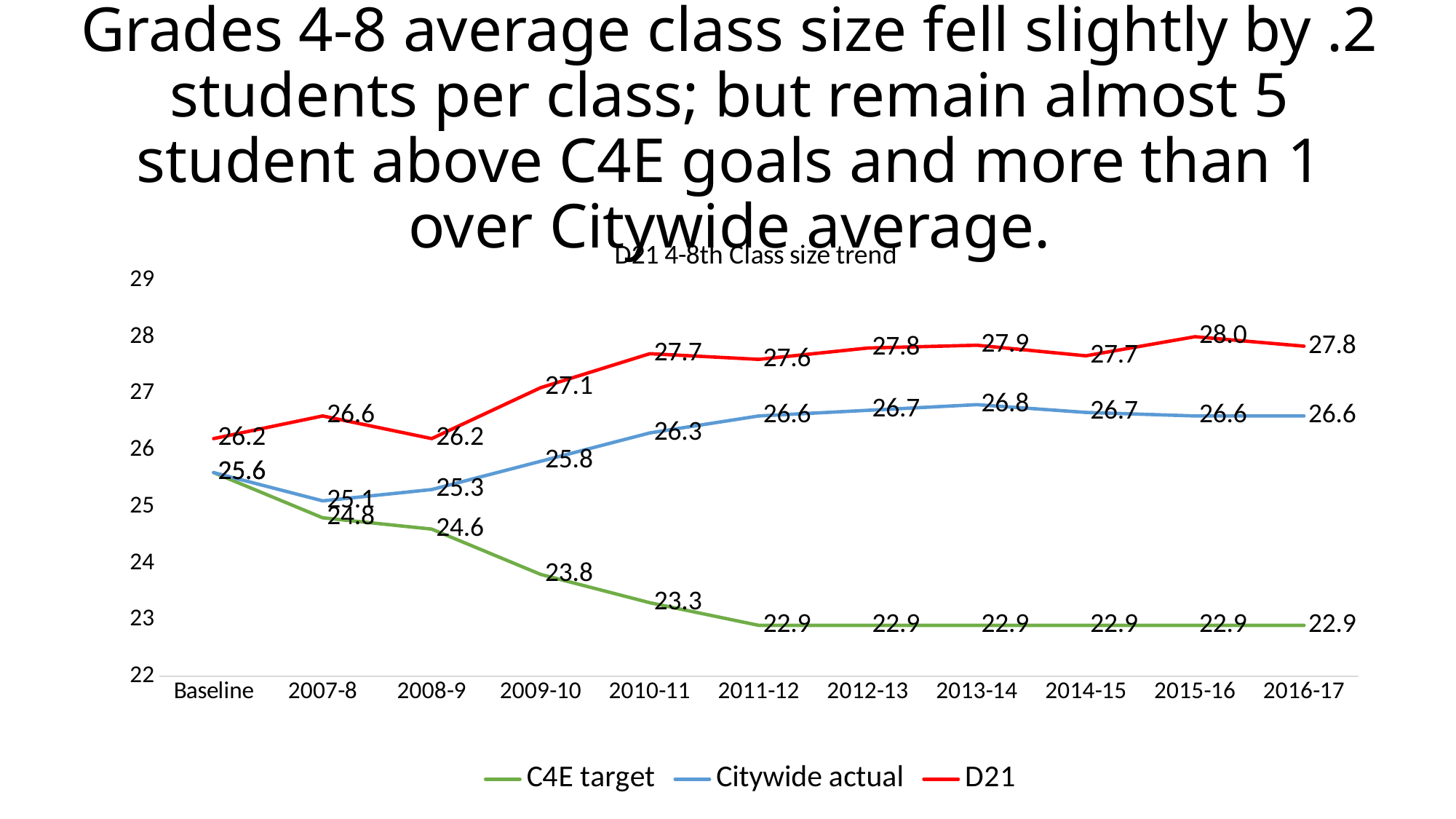
Does the C4E target series rise or fall from Baseline to 2011-12? Fall What is the D21 value for 2015-16? 28.0 Which is larger in 2008-9, the D21 value or the Citywide actual value? D21 What kind of chart is shown on the slide? Line chart How many categories are shown on the x axis? 11 In which year is the Citywide actual value lowest? 2007-8 What is the C4E target value for 2009-10? 23.8 How many series does the legend list? 3 What is the Citywide actual value for 2013-14? 26.8 In which year does the D21 series reach its highest value? 2015-16 What is the difference between the D21 value in 2010-11 and the D21 value at Baseline? 1.5 What is the difference between the D21 value and the Citywide actual value in 2016-17? 1.2